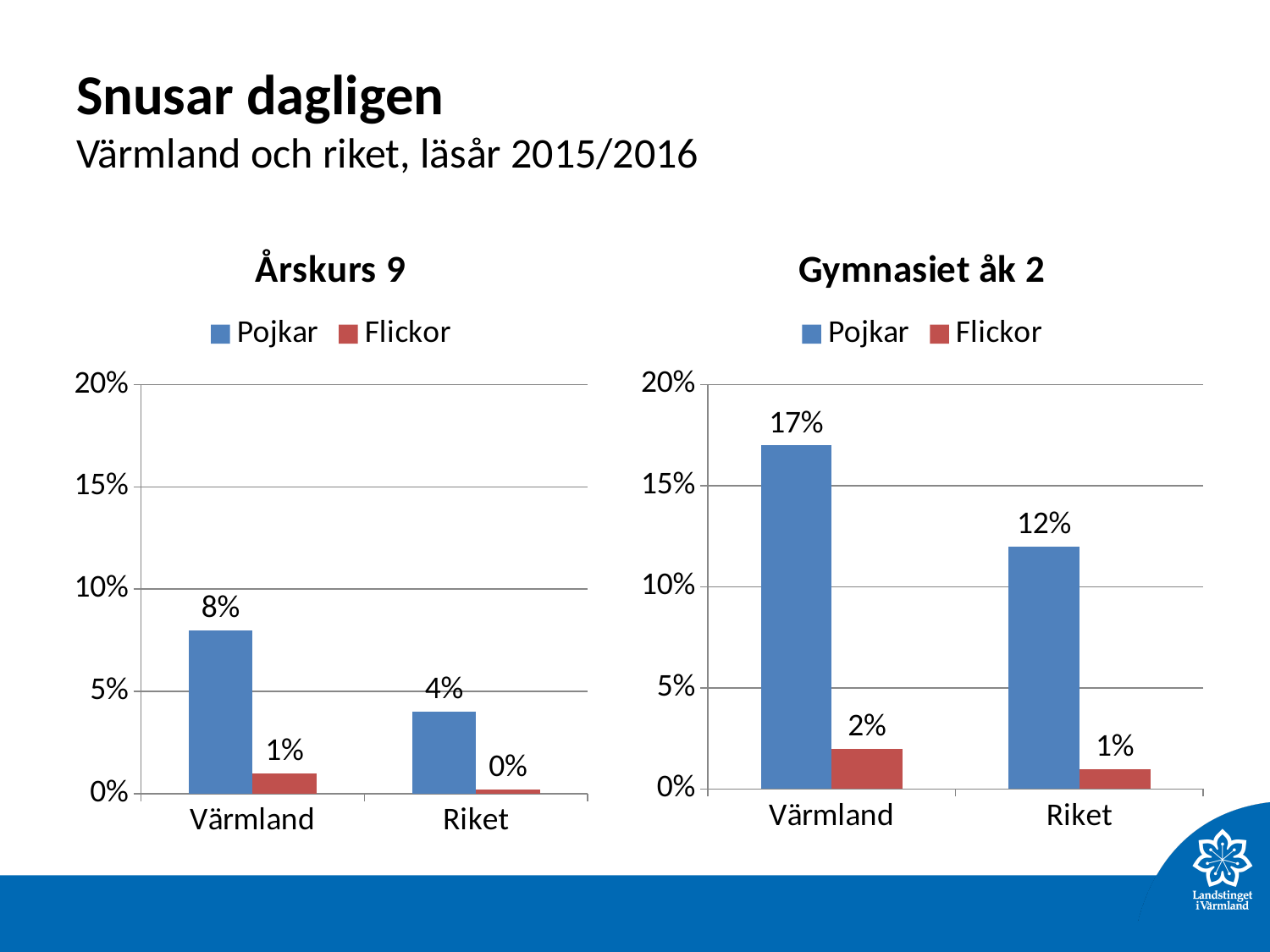
In the Gymnasiet åk 2 chart, what is the value for Pojkar in Värmland? 17% In the Årskurs 9 chart, which is larger: Pojkar in Värmland or Pojkar in Riket? Pojkar in Värmland In the Gymnasiet åk 2 chart, what is the difference between the Pojkar values for Värmland and Riket? 5% What kind of chart is the Gymnasiet åk 2 chart? Bar chart How many series does the legend of the Årskurs 9 chart list? 2 In the Årskurs 9 chart, what is the value for Pojkar in Värmland? 8% In the Årskurs 9 chart, which category has the lowest Flickor value? Riket In the Gymnasiet åk 2 chart, which category has the highest Pojkar value? Värmland In the Årskurs 9 chart, what is the value for Flickor in Riket? 0% In the Gymnasiet åk 2 chart, is the value for Pojkar in Riket greater or less than 10%? greater In the Gymnasiet åk 2 chart, what is the value for Flickor in Riket? 1% In the Gymnasiet åk 2 chart, what colour are the Flickor bars? Red